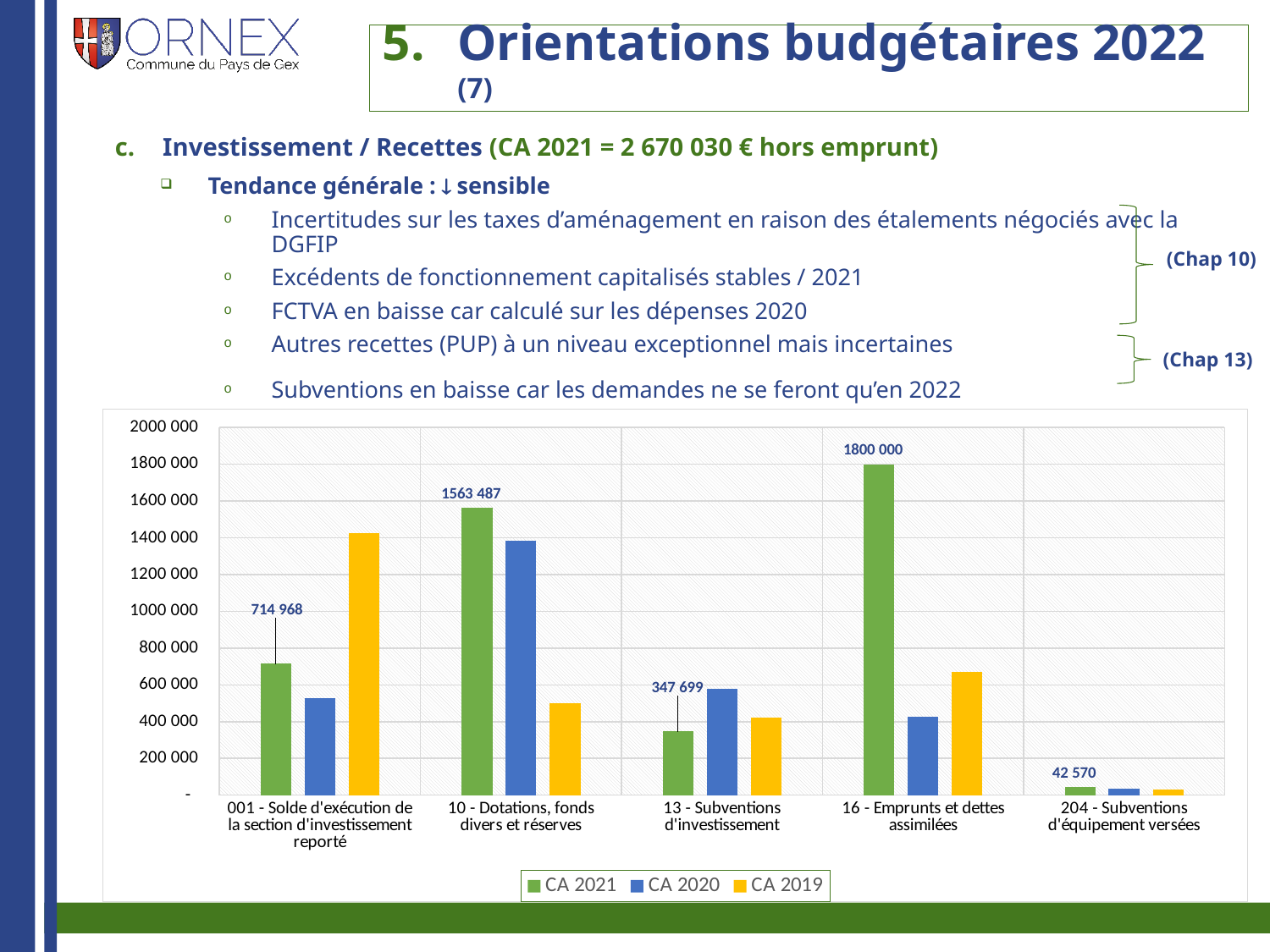
What is the CA 2021 value for "204 - Subventions d'équipement versées"? 42 570 What is the difference between the CA 2021 values for "16 - Emprunts et dettes assimilées" and "10 - Dotations, fonds divers et réserves"? 236 513 Which category has the highest CA 2021 value? 16 - Emprunts et dettes assimilées For "001 - Solde d'exécution de la section d'investissement reporté", which is larger: CA 2019 or CA 2021? CA 2019 How many categories are shown on the x axis of the chart? 5 Which category has the lowest CA 2021 value? 204 - Subventions d'équipement versées Is the CA 2020 value for "10 - Dotations, fonds divers et réserves" greater or less than 1200 000? greater What is the CA 2021 value for "16 - Emprunts et dettes assimilées"? 1800 000 What is the CA 2021 value for "10 - Dotations, fonds divers et réserves"? 1563 487 What is the CA 2021 value for "13 - Subventions d'investissement"? 347 699 What kind of chart is shown on the slide? bar chart How many series does the chart legend list? 3